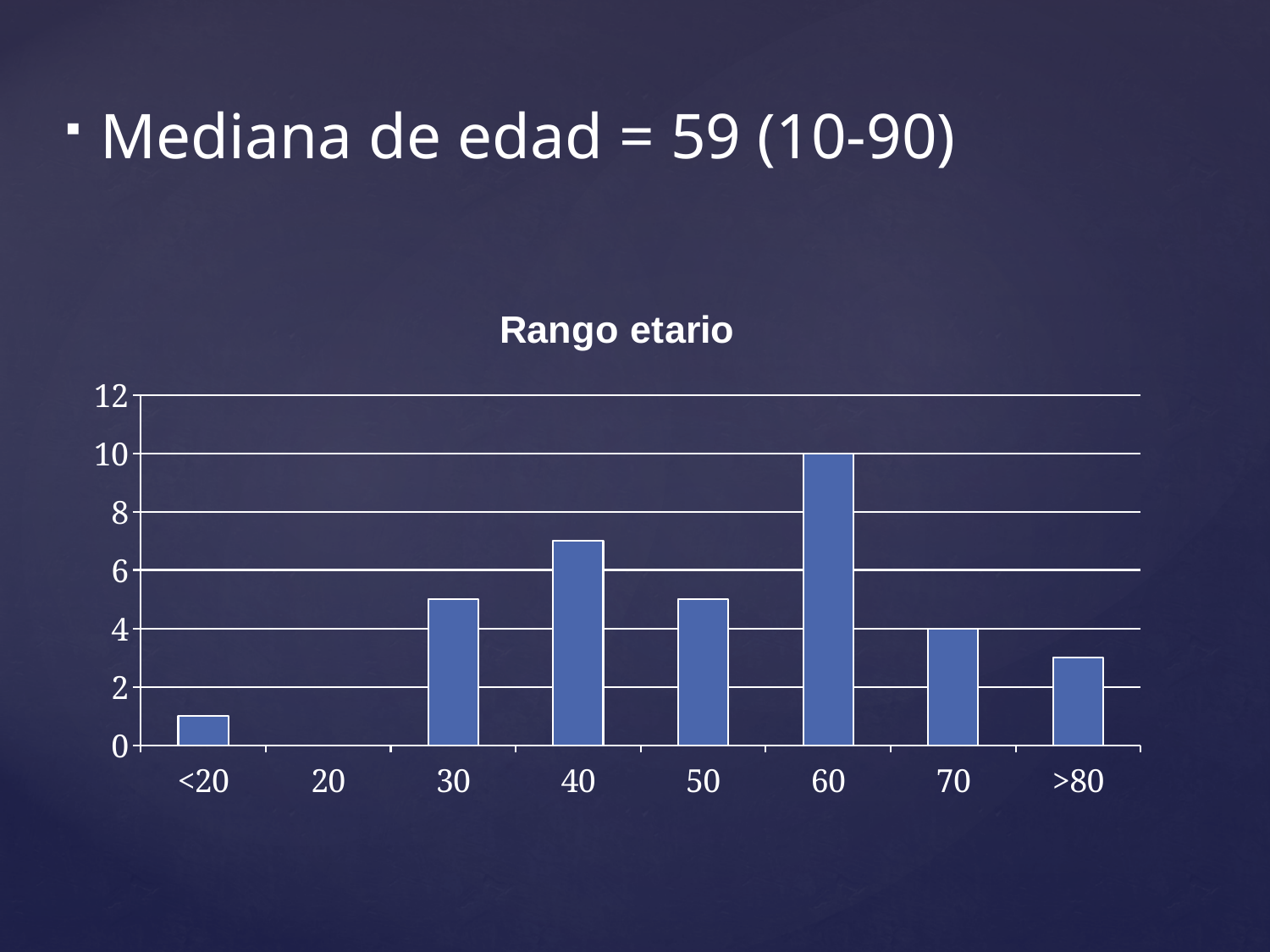
What is the value for the 70 age range? 4 What is the title of the chart? Rango etario Is the value for the >80 age range greater or less than 4? less What is the value for the 60 age range? 10 How many age-range categories are shown on the x axis? 8 Is the value for the 40 age range greater or less than 6? greater Do the values rise or fall from the 60 age range to the >80 age range? fall Which age range has the highest value? 60 What is the difference between the values for the 60 and 70 age ranges? 6 What kind of chart is shown on the slide? bar chart Is the value for the <20 age range greater or less than 2? less Which has the larger value, the 40 age range or the 50 age range? 40